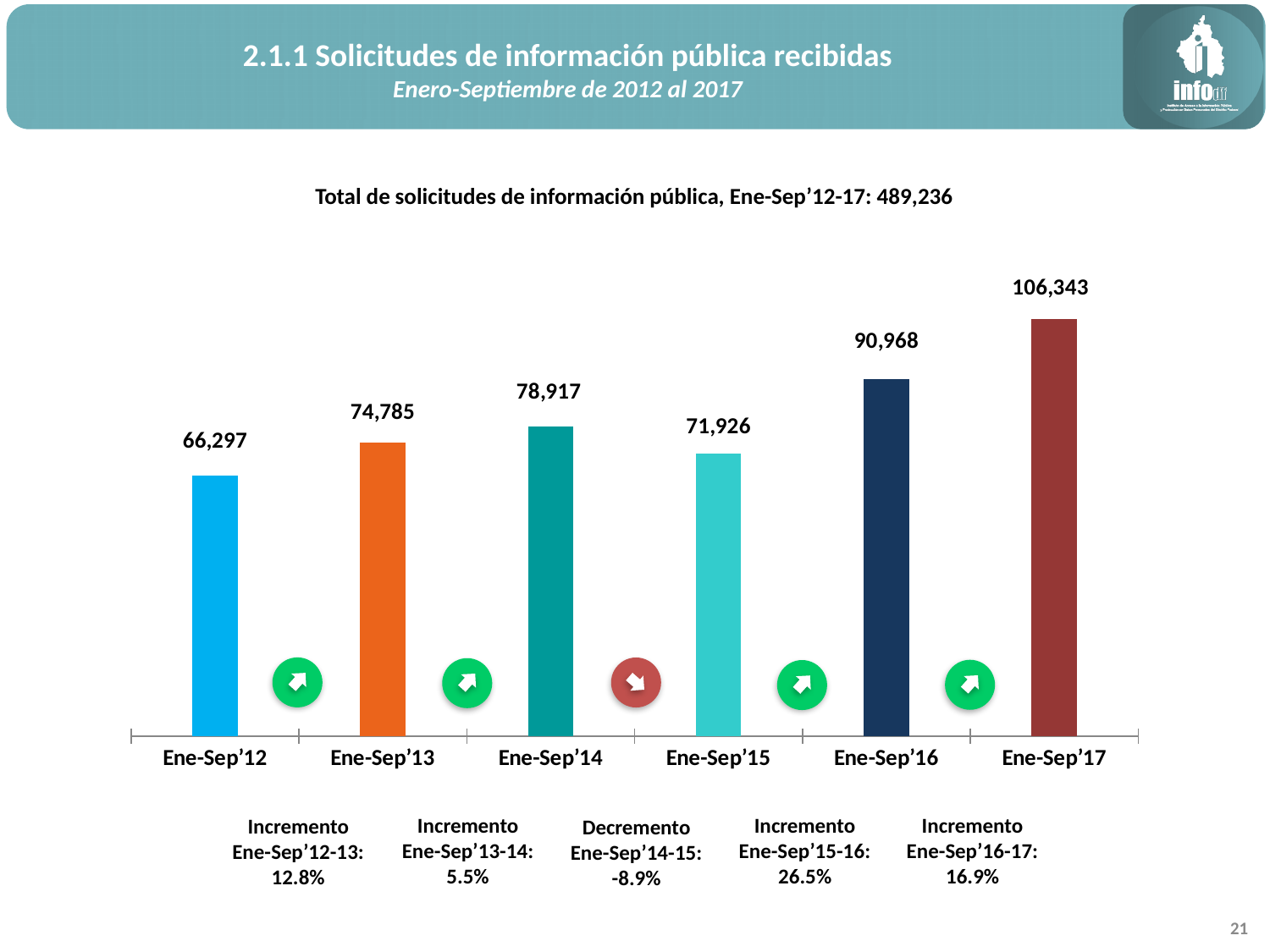
What is the value for Ene-Sep'15? 71,926 What is the value for Ene-Sep'12? 66,297 What is the difference between the values for Ene-Sep'17 and Ene-Sep'16? 15,375 Which period has the lowest value? Ene-Sep'12 What total of solicitudes for Ene-Sep'12-17 is stated above the chart? 489,236 Between which two consecutive periods does the value decrease? Ene-Sep'14 to Ene-Sep'15 Which period has the highest value? Ene-Sep'17 How many periods are shown on the x axis? 6 What is the difference between the values for Ene-Sep'14 and Ene-Sep'15? 6,991 What kind of chart is shown on the slide? Bar chart What is the value for Ene-Sep'17? 106,343 Which is larger, the value for Ene-Sep'13 or the value for Ene-Sep'15? Ene-Sep'13